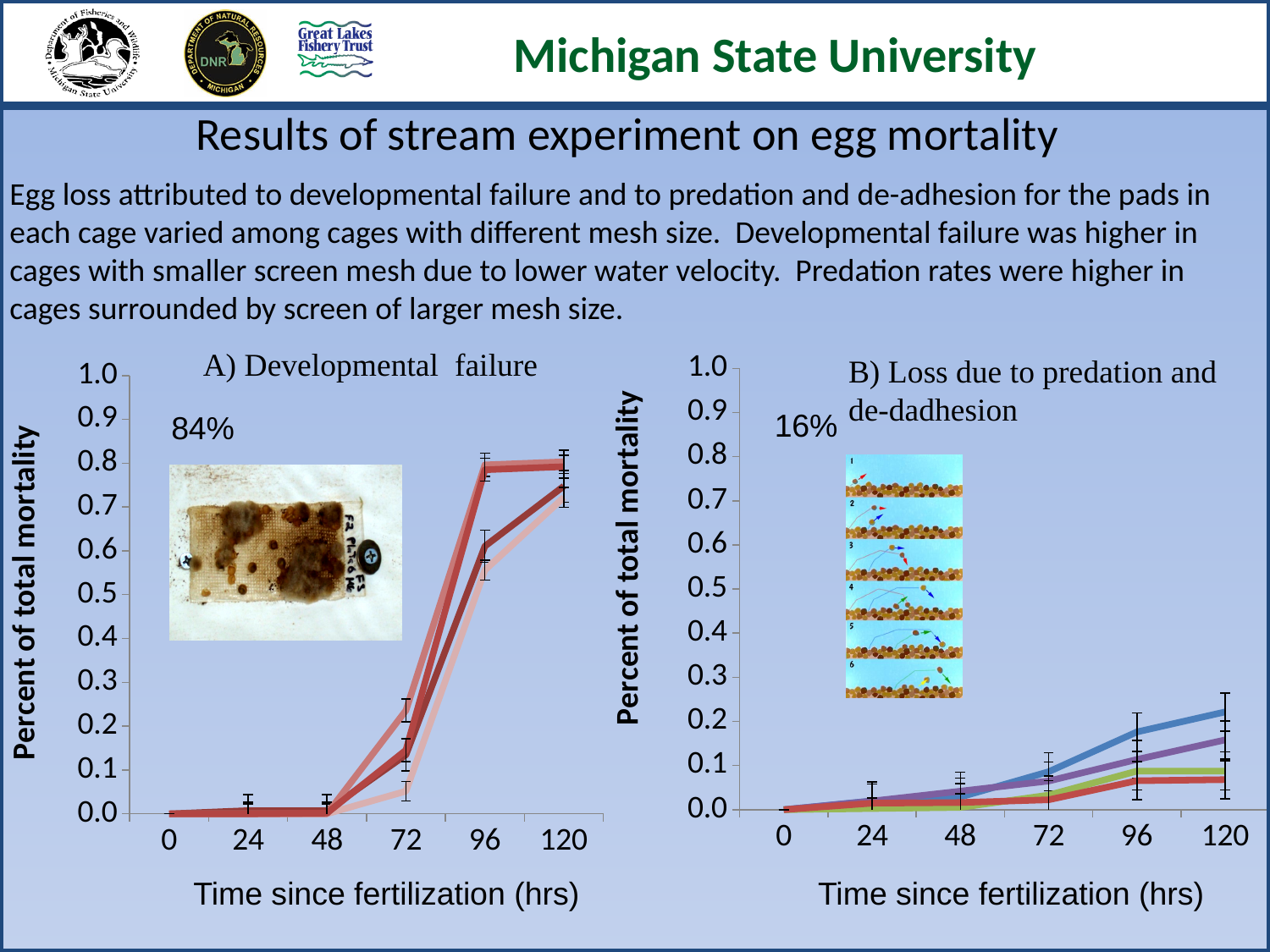
In chart A (Developmental failure), how many time points are marked on the x axis? 6 What kind of chart is chart B (Loss due to predation and de-adhesion)? line chart What is the y-axis label on chart A (Developmental failure)? Percent of total mortality In chart B (Loss due to predation and de-adhesion), which line has the highest value at 120 hrs? the blue line In chart A (Developmental failure), is the value of the highest line at 96 hrs greater or less than 0.7? greater In chart A (Developmental failure), do the plotted values rise or fall from 48 hrs to 96 hrs? rise What percentage is annotated on chart A (Developmental failure)? 84% In chart B (Loss due to predation and de-adhesion), is the value of the blue line at 120 hrs greater or less than 0.3? less What kind of chart is chart A (Developmental failure)? line chart What percentage is annotated on chart B (Loss due to predation and de-adhesion)? 16% In chart B (Loss due to predation and de-adhesion), how many time points are marked on the x axis? 6 In chart A (Developmental failure), are the values at 72 hrs greater or less than 0.3? less